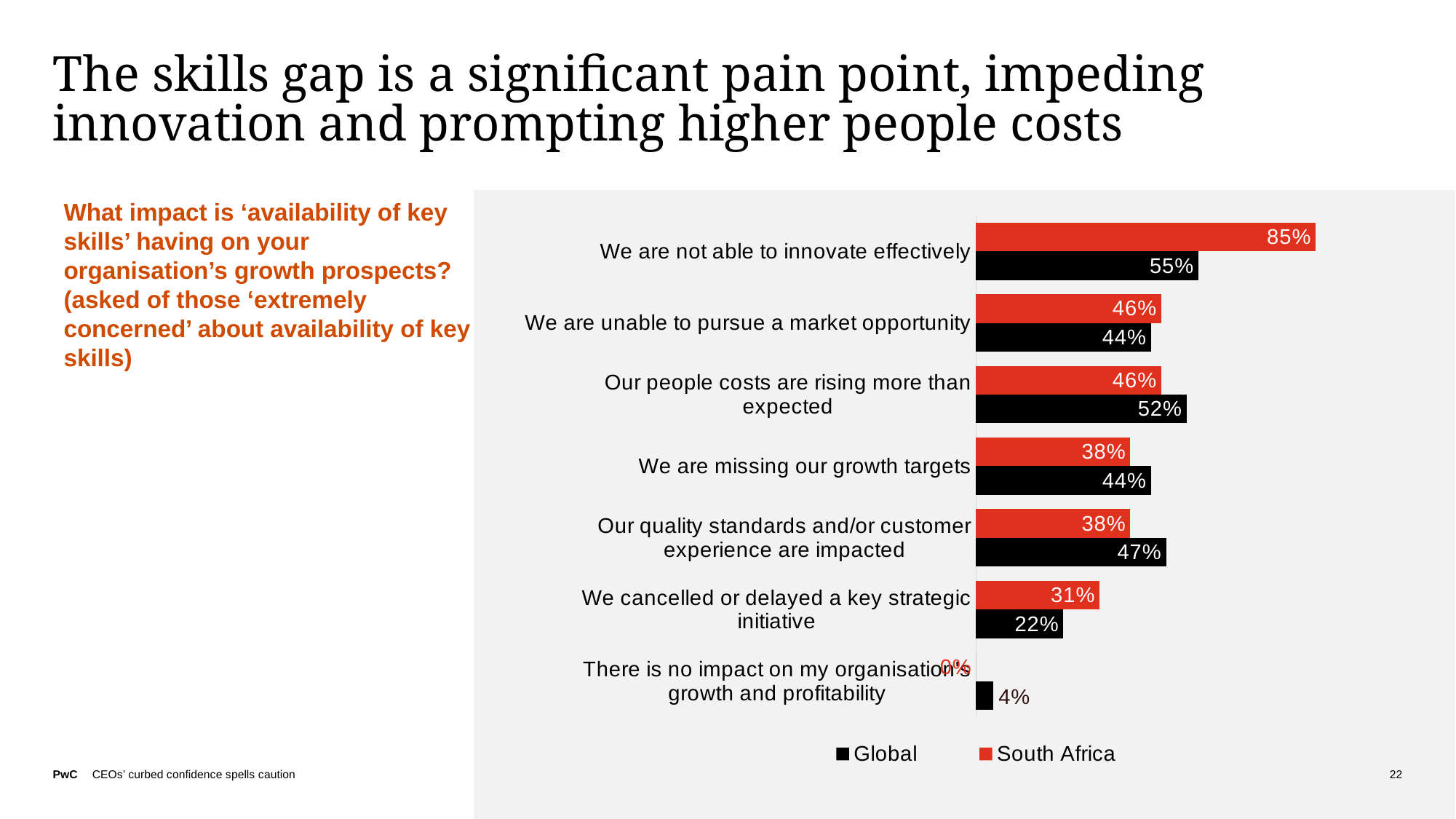
For 'Our quality standards and/or customer experience are impacted', which is larger: the Global value or the South Africa value? Global Which colour represents the South Africa series in the chart? Red What is the South Africa value for 'We are not able to innovate effectively'? 85% Which category has the highest South Africa value? We are not able to innovate effectively What is the South Africa value for 'We are missing our growth targets'? 38% How many series does the legend list? 2 What is the Global value for 'Our people costs are rising more than expected'? 52% What is the Global value for 'We cancelled or delayed a key strategic initiative'? 22% What kind of chart is shown on the slide? Bar chart How many categories are shown in the chart? 7 What is the difference between the South Africa and Global values for 'We are not able to innovate effectively'? 30% Which category has the lowest Global value? There is no impact on my organisation's growth and profitability